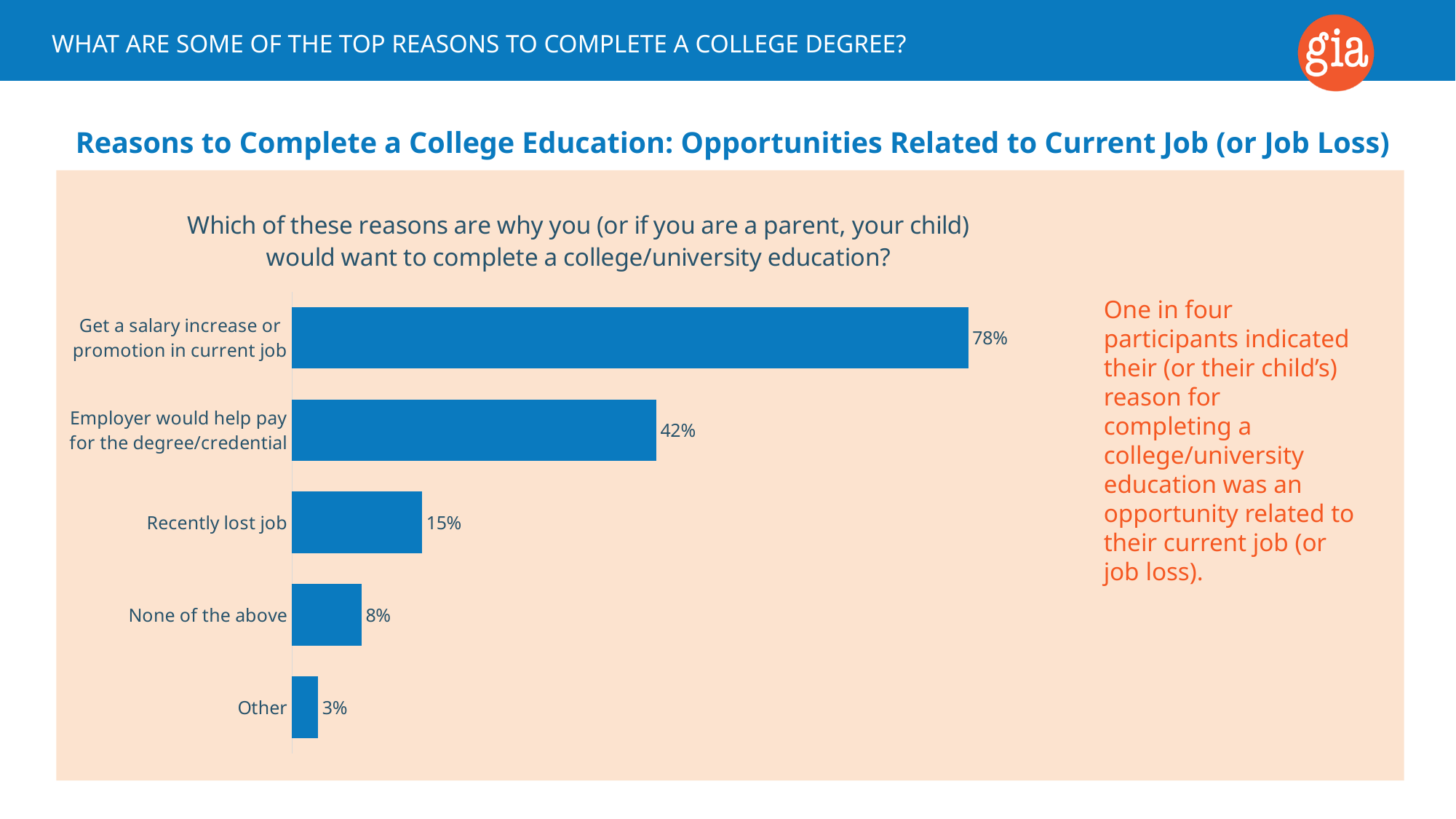
What percentage of respondents chose "Get a salary increase or promotion in current job" as a reason? 78% How many categories are shown in the chart? 5 What is the value for "None of the above"? 8% Which is larger: "Recently lost job" or "Other"? Recently lost job What percentage is shown for "Recently lost job"? 15% What is the title of the chart on the slide? Which of these reasons are why you (or if you are a parent, your child) would want to complete a college/university education? What is the value shown for "Employer would help pay for the degree/credential"? 42% Which reason has the highest percentage? Get a salary increase or promotion in current job What type of chart is shown on the slide? Bar chart What is the difference between "Recently lost job" and "None of the above"? 7% What is the difference between "Get a salary increase or promotion in current job" and "Employer would help pay for the degree/credential"? 36% Which category has the lowest value? Other